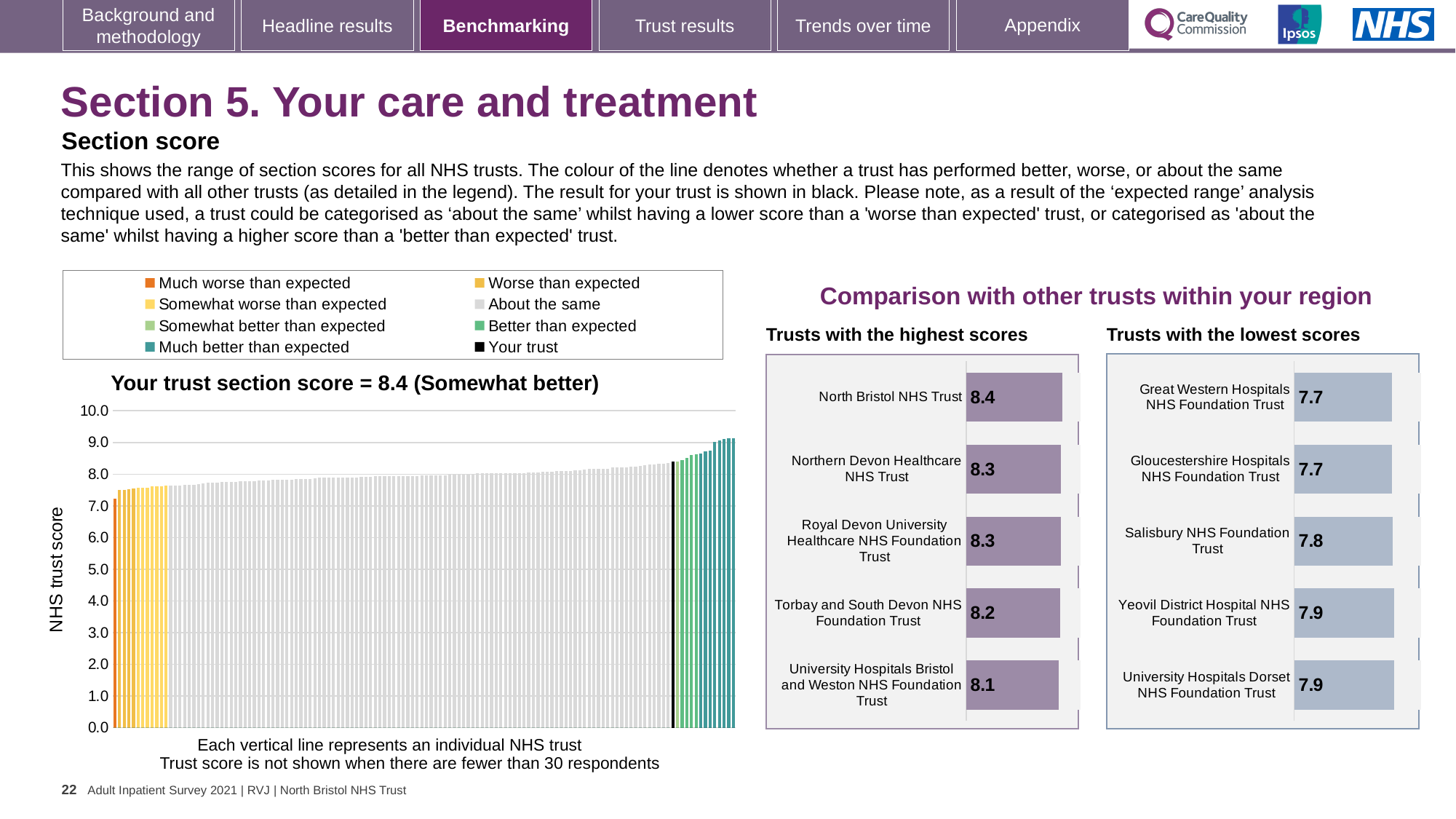
In the 'Trusts with the highest scores' chart, which trust has the lowest score? University Hospitals Bristol and Weston NHS Foundation Trust In the large chart on the left, is the value of the leftmost bar greater or less than 8.0? less What kind of chart is the large chart on the left titled 'Your trust section score = 8.4 (Somewhat better)'? Bar chart In the large chart on the left, do the bar heights rise or fall from left to right? Rise In the 'Trusts with the lowest scores' chart, what is the score for Salisbury NHS Foundation Trust? 7.8 In the 'Trusts with the lowest scores' chart, which is larger: the score for Salisbury NHS Foundation Trust or Yeovil District Hospital NHS Foundation Trust? Yeovil District Hospital NHS Foundation Trust In the large chart on the left, what is the label on the vertical axis? NHS trust score How many entries does the legend above the large chart on the left list? 8 In the 'Trusts with the lowest scores' chart, what is the score for Great Western Hospitals NHS Foundation Trust? 7.7 How many trusts are shown in the 'Trusts with the highest scores' chart? 5 In the 'Trusts with the highest scores' chart, what is the difference between the scores of North Bristol NHS Trust and University Hospitals Bristol and Weston NHS Foundation Trust? 0.3 In the 'Trusts with the highest scores' chart, what is the score for North Bristol NHS Trust? 8.4